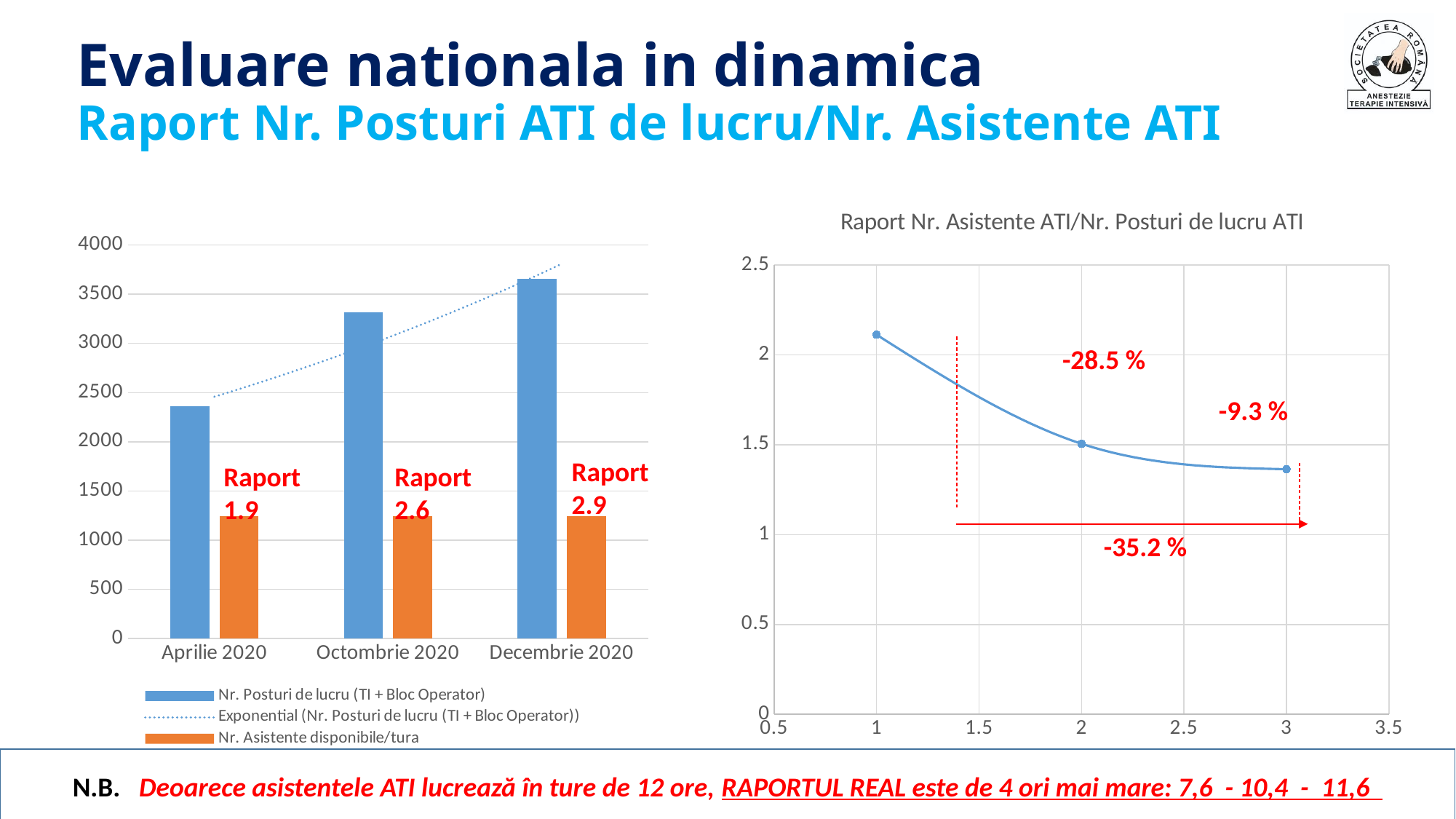
On the left bar chart, how many categories are shown on the x axis? 3 On the chart titled 'Raport Nr. Asistente ATI/Nr. Posturi de lucru ATI', do the values rise or fall along the x axis? fall On the left bar chart, is the value for Nr. Posturi de lucru (TI + Bloc Operator) in Decembrie 2020 greater or less than 3500? greater On the left bar chart, is the value for Nr. Posturi de lucru (TI + Bloc Operator) in Aprilie 2020 greater or less than 2000? greater What kind of chart is the chart on the left of the slide? bar chart On the left bar chart, do the values for Nr. Posturi de lucru (TI + Bloc Operator) rise or fall from Aprilie 2020 to Decembrie 2020? rise On the chart titled 'Raport Nr. Asistente ATI/Nr. Posturi de lucru ATI', what percentage change is annotated for the overall decline from the first to the last point? -35.2 % On the left bar chart, how many entries does the legend list? 3 On the left bar chart, which category has the highest value for Nr. Posturi de lucru (TI + Bloc Operator)? Decembrie 2020 On the chart titled 'Raport Nr. Asistente ATI/Nr. Posturi de lucru ATI', how many data points are plotted? 3 On the left bar chart, what is the 'Raport' value annotated for Decembrie 2020? 2.9 On the left bar chart, what is the 'Raport' value annotated for Aprilie 2020? 1.9